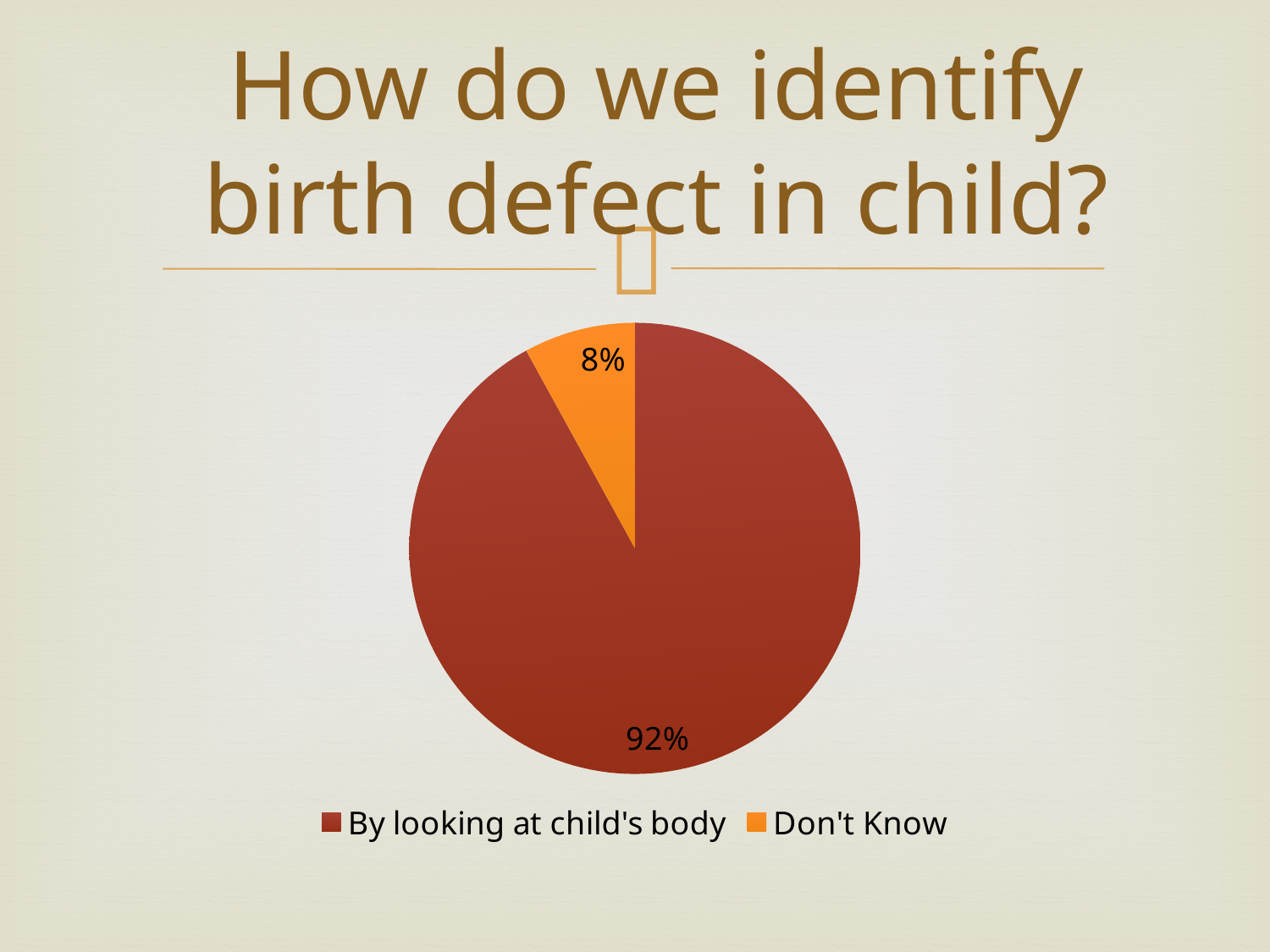
What colour is the "Don't Know" slice? orange What is the difference in percentage points between "By looking at child's body" and "Don't Know"? 84 What kind of chart is shown on the slide? pie chart Which category has the largest share of the pie? By looking at child's body What is the title of the slide containing the pie chart? How do we identify birth defect in child? Which is larger: the share for "Don't Know" or the share for "By looking at child's body"? By looking at child's body How many slices does the pie chart have? 2 Which category has the smallest share of the pie? Don't Know How many entries does the legend list? 2 What percentage of the pie is labelled "By looking at child's body"? 92% What percentage of the pie is labelled "Don't Know"? 8% What is the share of the pie taken by the "Don't Know" slice? 8%